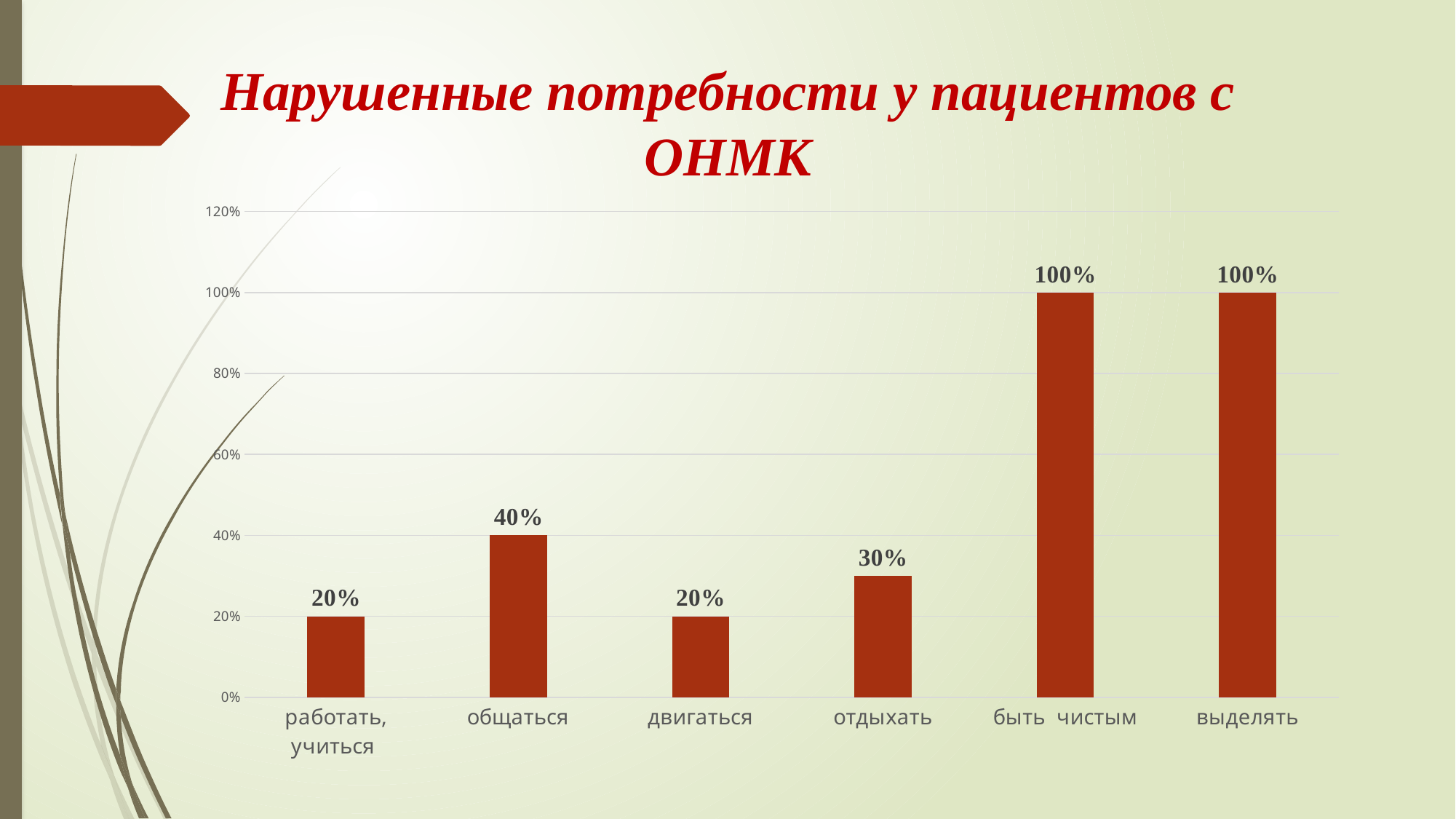
How many categories are shown on the x axis? 6 What is the difference between the values for общаться and отдыхать? 10% What is the value for выделять? 100% Which is larger, the value for общаться or the value for двигаться? общаться What is the value for двигаться? 20% What is the difference between the values for быть чистым and работать, учиться? 80% What kind of chart is shown on the slide? bar chart What is the title of the slide? Нарушенные потребности у пациентов с ОНМК Which category has the lowest value among общаться, отдыхать and быть чистым? отдыхать What is the value for отдыхать? 30% What is the value for общаться? 40% Is the value for отдыхать greater or less than 40%? less